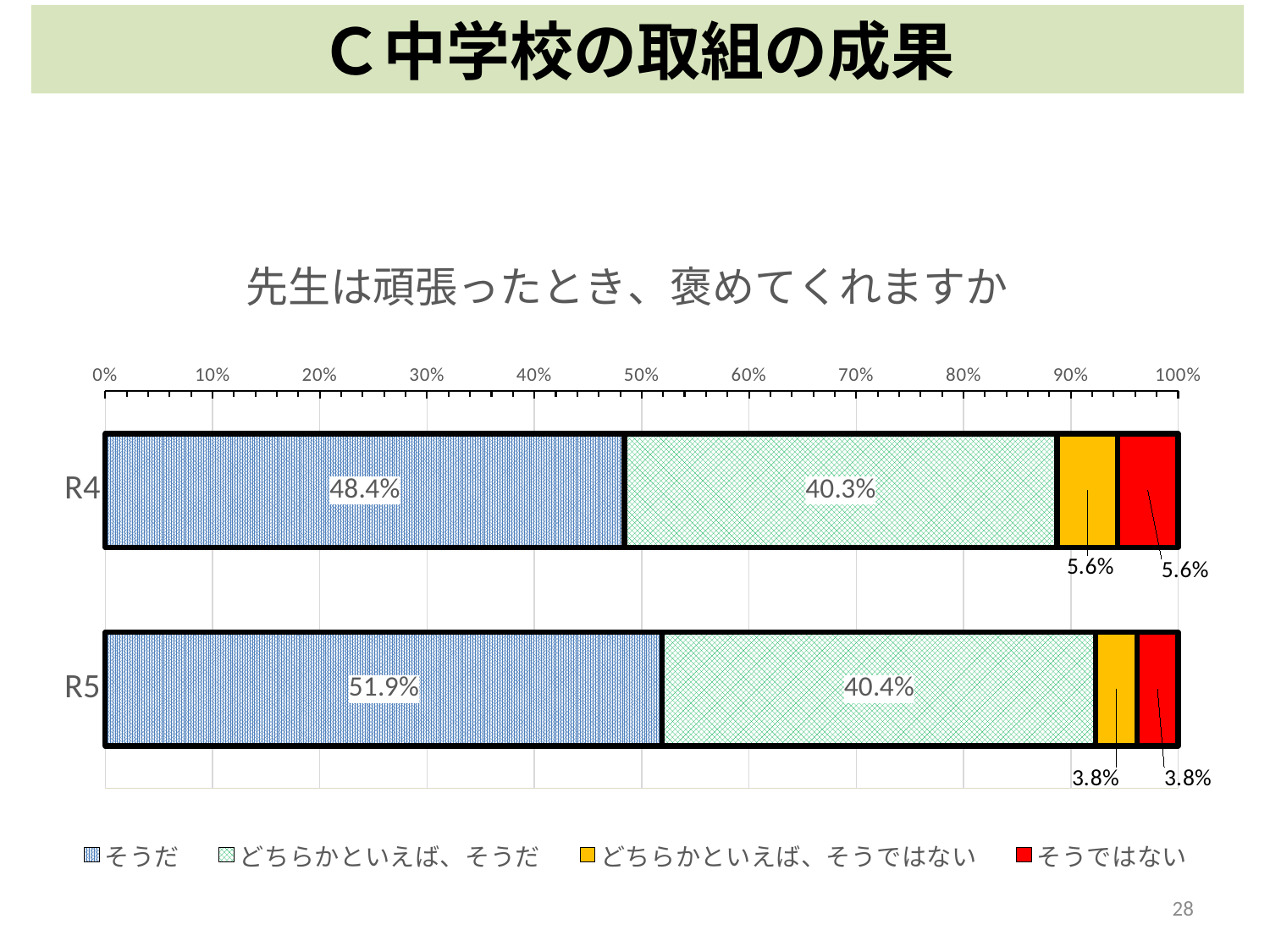
How many categories (years) are shown on the chart? 2 How many series does the legend list? 4 What is the value for どちらかといえば、そうではない in R5? 3.8% What is the title of the chart? 先生は頑張ったとき、褒めてくれますか What is the difference between the そうではない values for R4 and R5? 1.8% What is the value for どちらかといえば、そうだ in R5? 40.4% What is the value for そうだ in R4? 48.4% Which year has the larger value for そうだ, R4 or R5? R5 What kind of chart is shown? Stacked horizontal bar chart What is the difference between the そうだ values for R5 and R4? 3.5% What is the value for そうだ in R5? 51.9% What is the value for そうではない in R4? 5.6%